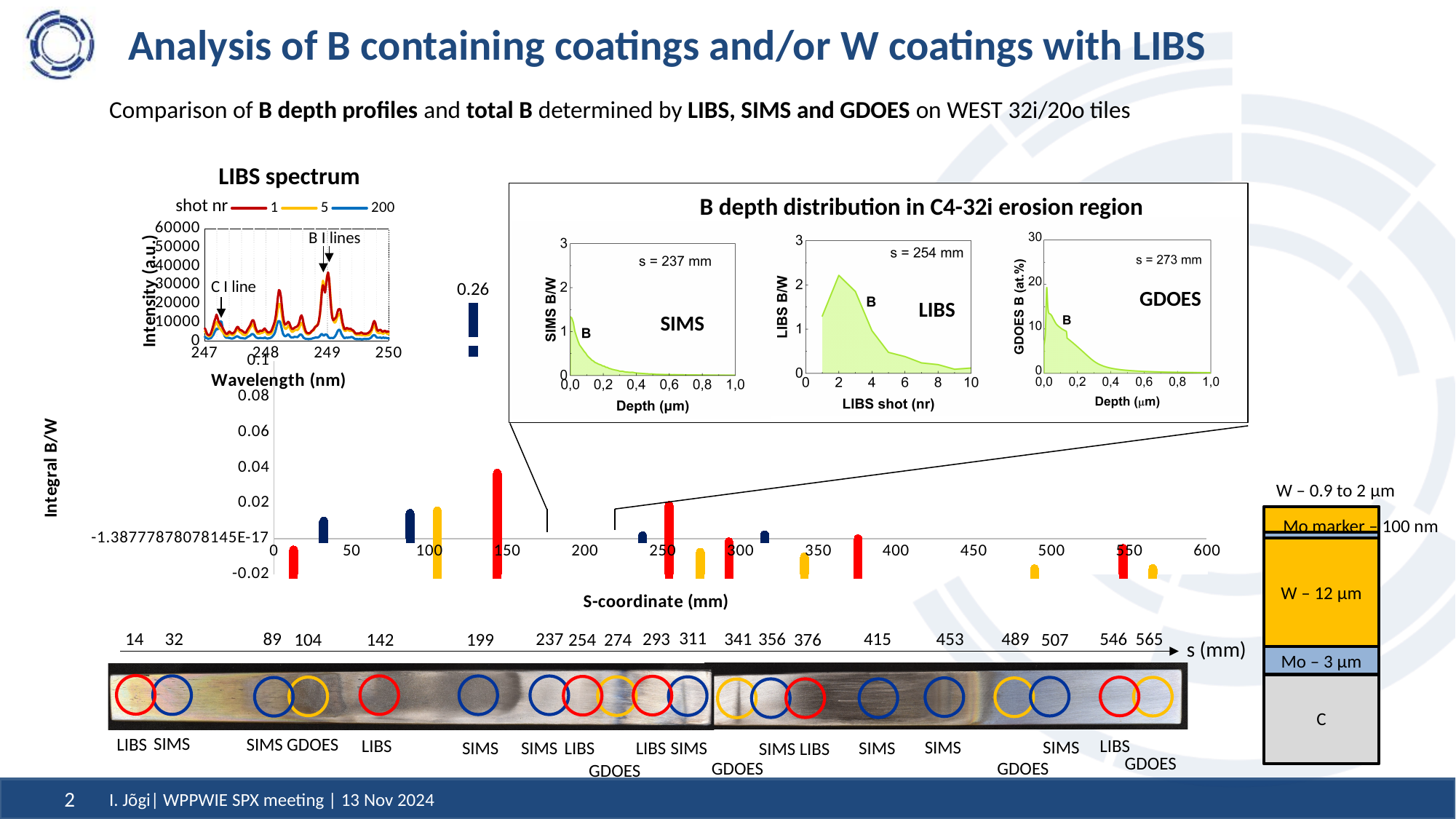
In the 'B depth distribution in C4-32i erosion region' panel, at which s-coordinate was the GDOES profile measured? s = 273 mm In the 'B depth distribution in C4-32i erosion region' panel, is the peak LIBS B/W value greater or less than 2? greater In the 'B depth distribution in C4-32i erosion region' panel, does the SIMS B/W value rise or fall with increasing depth? fall How many series does the legend of the 'LIBS spectrum' chart list? 3 In the 'Integral B/W' bar chart, is the blue bar at about 32 mm greater or less than 0.02? less In the 'Integral B/W' bar chart, is the red bar at about 142 mm greater or less than 0.02? greater What kind of chart is the 'Integral B/W' versus 'S-coordinate (mm)' chart? bar chart In the 'LIBS spectrum' chart, which shot number has the highest intensity? 1 What is the highest value labelled on the y-axis of the 'Integral B/W' bar chart? 0.1 How many small charts are shown in the 'B depth distribution in C4-32i erosion region' panel? 3 What is the x-axis label of the 'LIBS spectrum' chart? Wavelength (nm) What kind of chart is the 'LIBS spectrum' chart? line chart